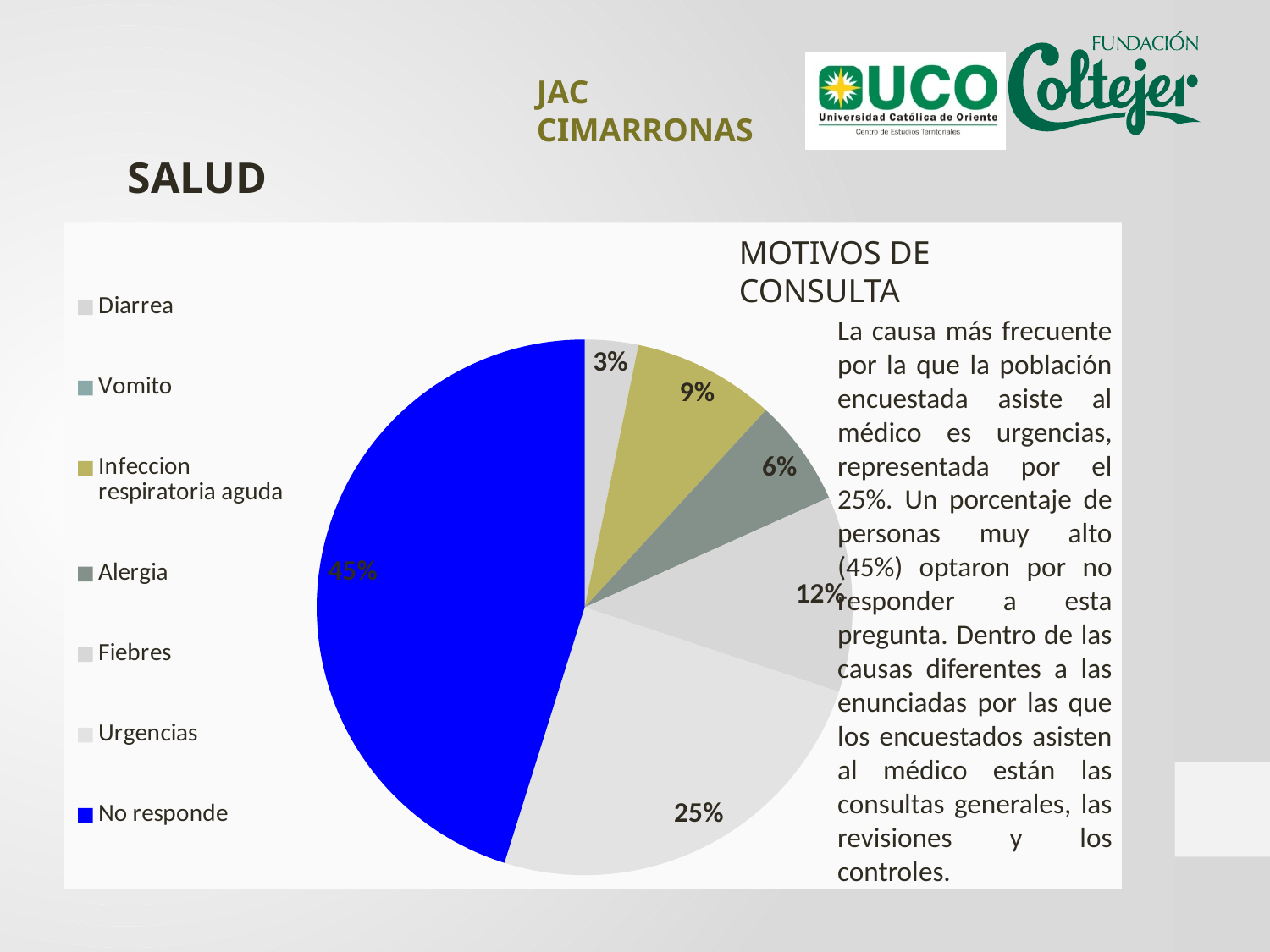
What colour is the slice for 'No responde'? blue Which is larger, the slice for 'Urgencias' or the slice for 'Infeccion respiratoria aguda'? Urgencias What is the value shown for 'Diarrea'? 3% What percentage of the pie does 'No responde' represent? 45% What kind of chart is shown on the slide? pie chart Which is larger, the slice for 'Diarrea' or the slice for 'Infeccion respiratoria aguda'? Infeccion respiratoria aguda Which category has the largest slice of the pie? No responde What is the value shown for 'Urgencias'? 25% How many categories does the legend list? 7 What is the value shown for 'Infeccion respiratoria aguda'? 9% What is the difference in percentage points between 'No responde' and 'Urgencias'? 20 What is the title of the pie chart? MOTIVOS DE CONSULTA